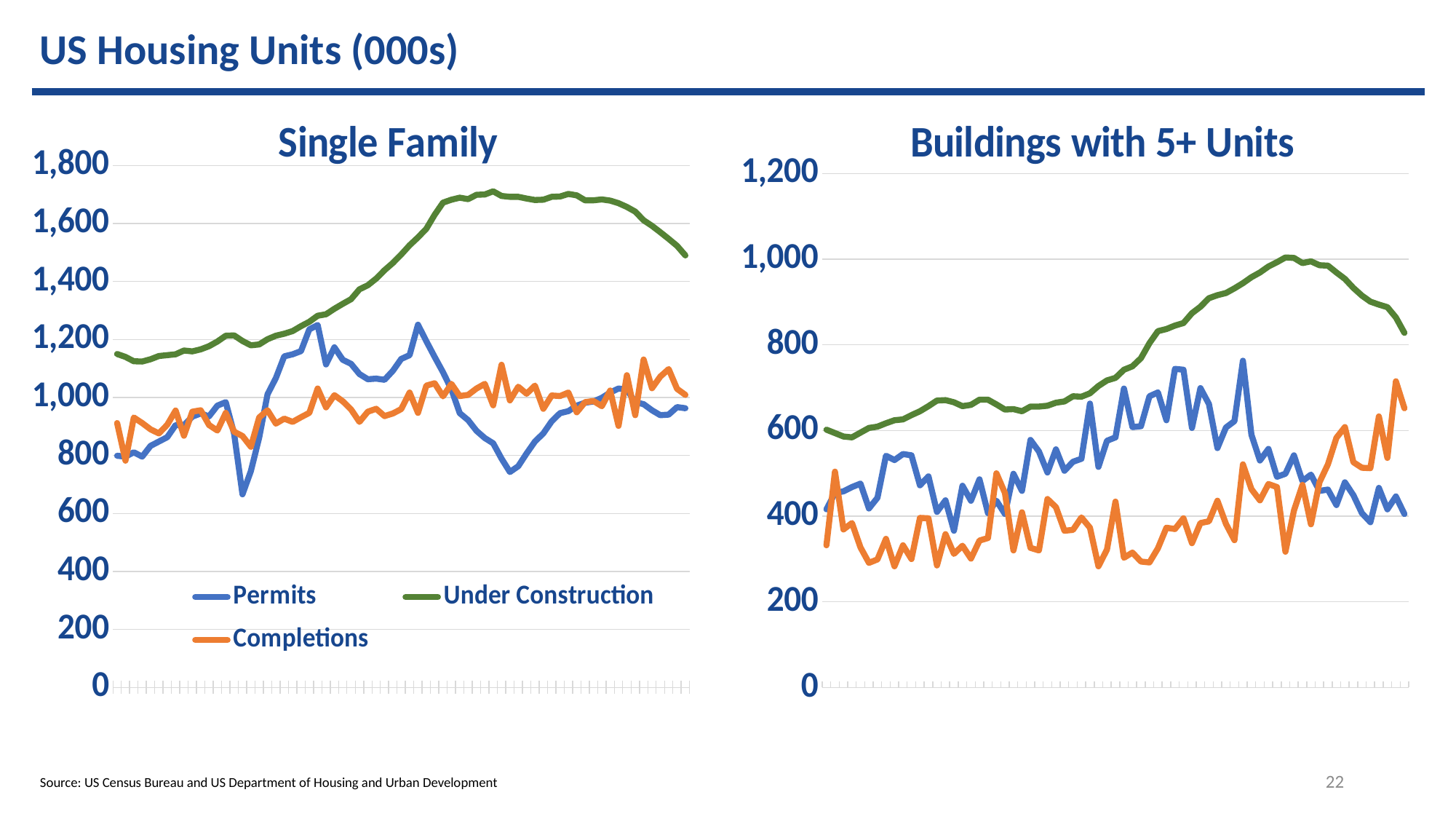
What kind of chart is the Single Family chart? line chart In the Single Family chart, at the right-hand end of the x axis, which is higher: Under Construction or Permits? Under Construction How many charts are shown on the slide? 2 In the Buildings with 5+ Units chart, is the Under Construction value at the left-hand start of the x axis greater or less than 800? less How many series does the legend on the Single Family chart list? 3 In the Single Family chart, is the lowest value of the Permits line greater or less than 800? less In the Buildings with 5+ Units chart, is the peak value of the Under Construction line greater or less than 900? greater What are the three series named in the legend of the Single Family chart? Permits, Under Construction, Completions In the Buildings with 5+ Units chart, does the Under Construction line rise or fall over its final stretch at the right of the x axis? fall In the Single Family chart, which series reaches the highest value overall? Under Construction